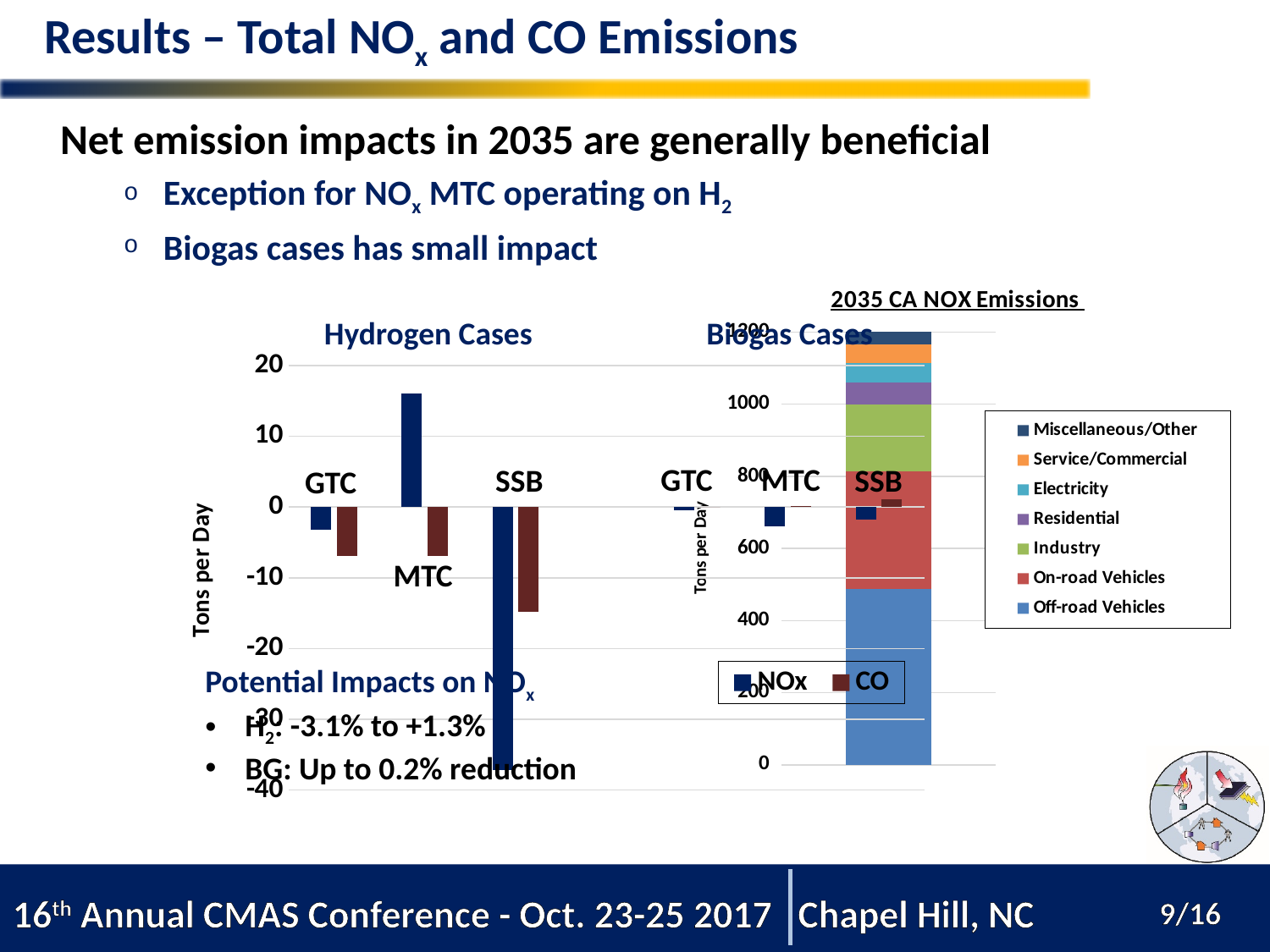
In the Hydrogen Cases chart, is the NOx value for MTC greater or less than 10? greater In the 2035 CA NOX Emissions chart, which sector contributes the largest share of the stacked bar? Off-road Vehicles How many series does the legend of the Hydrogen Cases / Biogas Cases chart list? 2 In the Hydrogen Cases chart, for GTC, which series shows the larger reduction, NOx or CO? CO In the Hydrogen Cases chart, which case shows the largest NOx reduction (lowest NOx value)? SSB In the Hydrogen Cases chart, which case shows an increase in NOx (highest NOx value)? MTC In the Hydrogen Cases chart, is the NOx value for SSB greater or less than -30? less In the 2035 CA NOX Emissions chart, is the total height of the stacked bar greater or less than 1000? greater What kind of chart is the Hydrogen Cases / Biogas Cases chart? bar chart How many categories does the legend of the 2035 CA NOX Emissions chart list? 7 What is the y-axis label of the Hydrogen Cases / Biogas Cases chart? Tons per Day